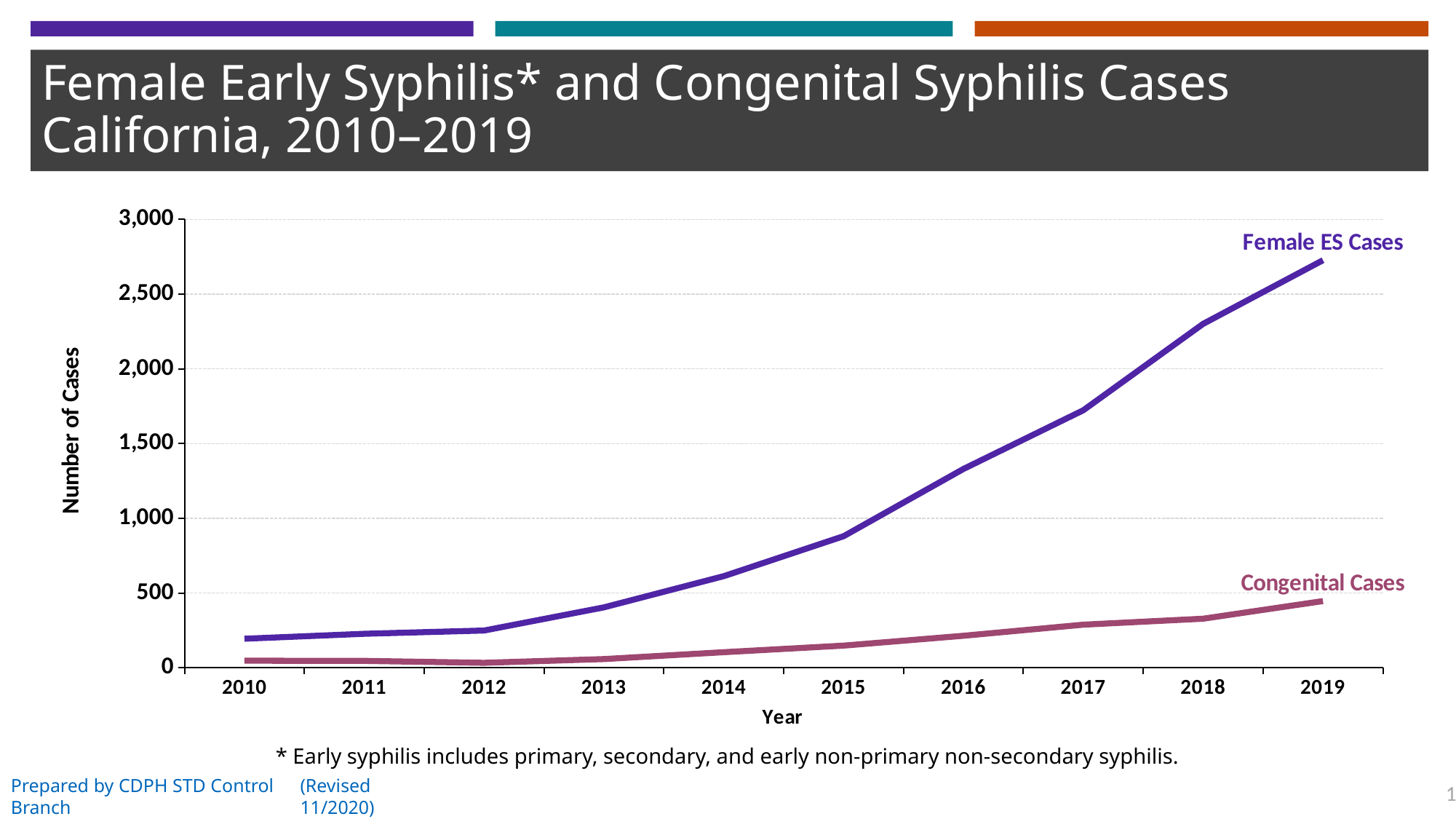
How many years are shown along the x axis? 10 In which year are Female ES Cases highest? 2019 Do Female ES Cases rise or fall from 2010 to 2019? rise Is the value for Female ES Cases in 2018 greater or less than 2,000? greater Is the value for Female ES Cases in 2019 greater or less than 2,500? greater What kind of chart is shown on the slide? line chart Is the value for Congenital Cases in 2019 greater or less than 500? less How many series are plotted on the chart? 2 In 2019, which series has the larger value, Female ES Cases or Congenital Cases? Female ES Cases What is the label on the vertical axis of the chart? Number of Cases In which year are Congenital Cases highest? 2019